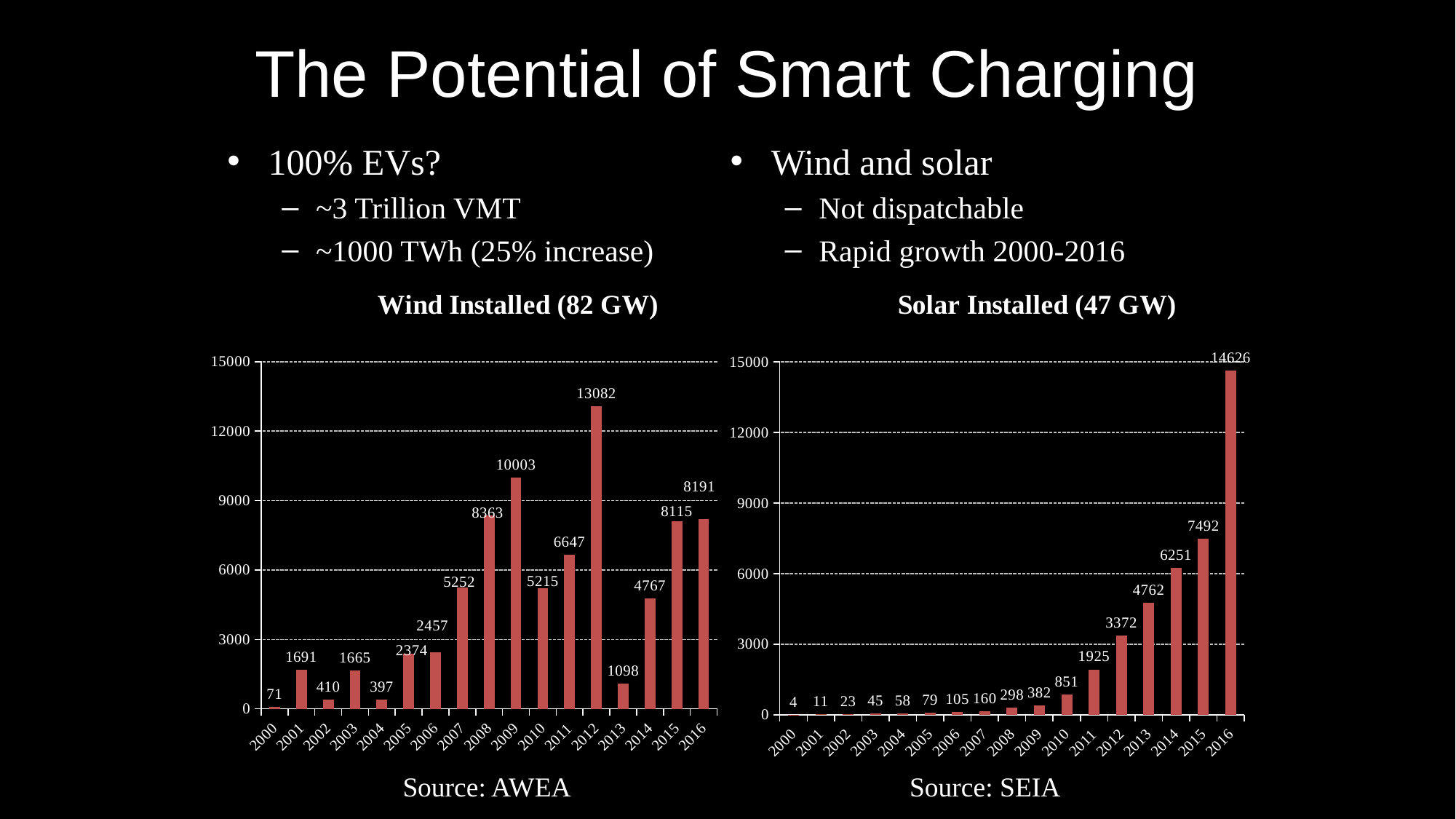
In the Solar Installed (47 GW) chart, what is the difference between the values for 2016 and 2015? 7134 In the Wind Installed (82 GW) chart, which is larger, the value for 2011 or the value for 2014? 2011 In the Solar Installed (47 GW) chart, is the value for 2013 greater or less than 3000? greater How many years are shown on the x axis of the Solar Installed (47 GW) chart? 17 In the Wind Installed (82 GW) chart, what is the difference between the values for 2009 and 2008? 1640 In the Wind Installed (82 GW) chart, which year has the highest value? 2012 In the Wind Installed (82 GW) chart, which year has the lowest value? 2000 In the Solar Installed (47 GW) chart, do the values generally rise or fall from 2000 to 2016? Rise In the Solar Installed (47 GW) chart, which year has the highest value? 2016 What kind of chart is the Wind Installed (82 GW) chart? Bar chart In the Solar Installed (47 GW) chart, what is the value for 2014? 6251 In the Wind Installed (82 GW) chart, what is the value for 2012? 13082